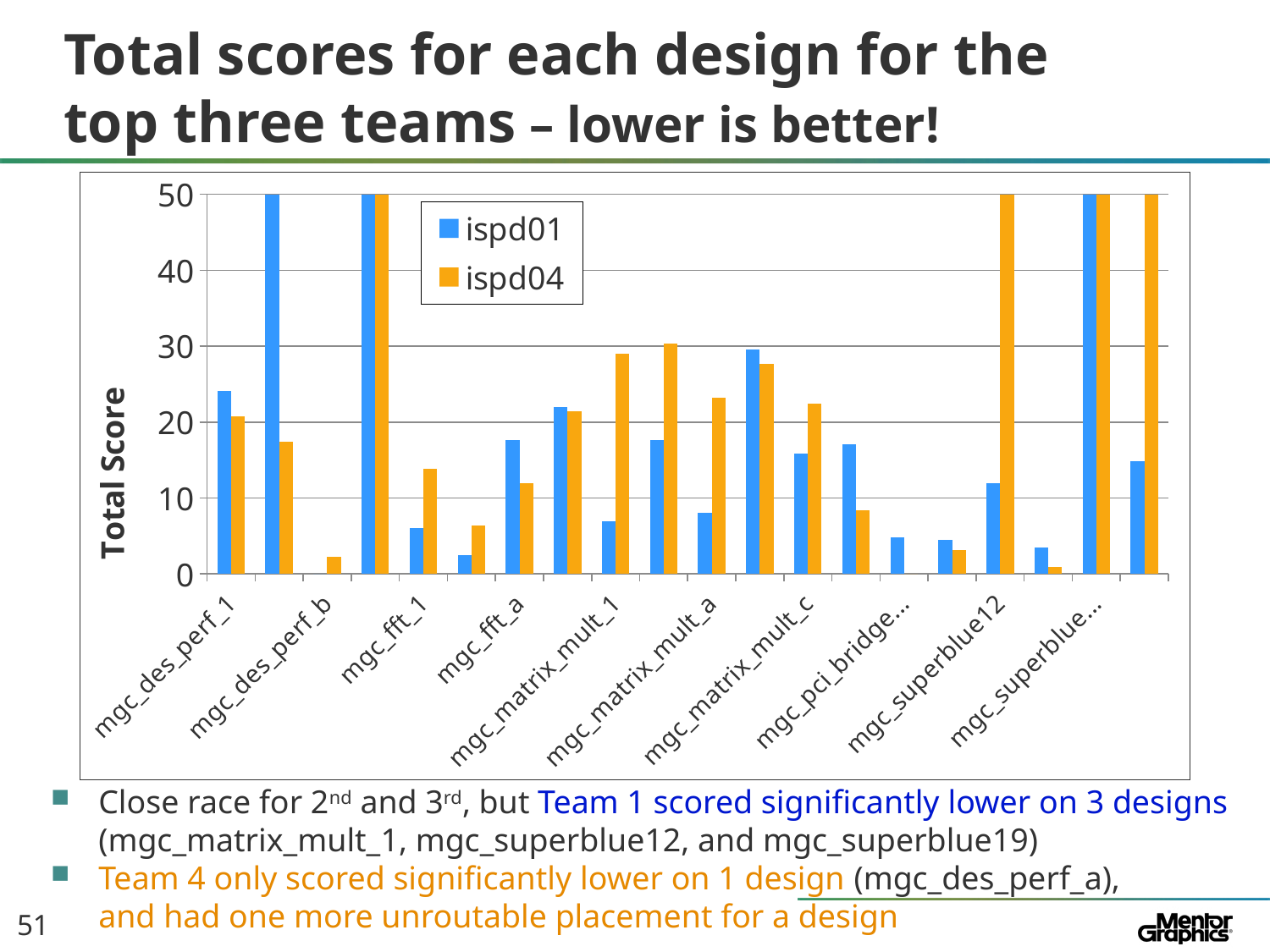
Is the ispd01 value for mgc_fft_1 greater or less than 10? less Is the ispd01 value for mgc_matrix_mult_a greater or less than 10? less How many series does the chart legend list? 2 Is the ispd01 value for mgc_des_perf_1 greater or less than 20? greater For mgc_fft_1, which series has the larger value, ispd01 or ispd04? ispd04 For mgc_des_perf_1, which series has the larger value, ispd01 or ispd04? ispd01 For mgc_superblue12, which series has the larger value, ispd01 or ispd04? ispd04 What kind of chart is shown on the slide? bar chart What is the title of the vertical axis of the chart? Total Score What are the two series named in the chart legend? ispd01 and ispd04